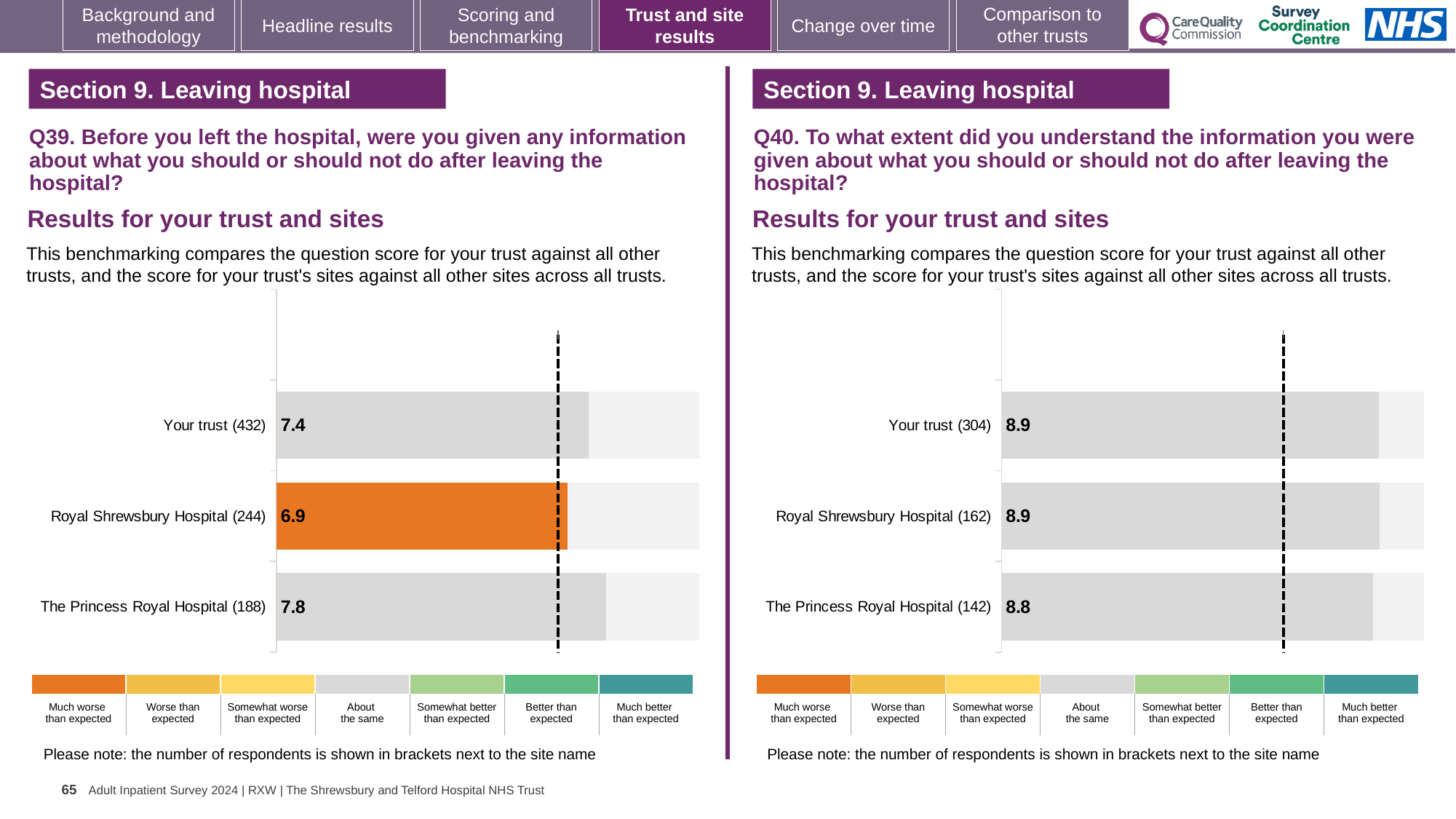
In the Q39 chart on the left, what is the score for Royal Shrewsbury Hospital? 6.9 In the Q39 chart on the left, what is the score for Your trust? 7.4 In the Q39 chart on the left, what is the difference between the scores for The Princess Royal Hospital and Royal Shrewsbury Hospital? 0.9 In the Q39 chart on the left, which bar is coloured orange, indicating 'Much worse than expected'? Royal Shrewsbury Hospital In the Q39 chart on the left, which bar has the lowest score? Royal Shrewsbury Hospital In the Q40 chart on the right, which of Your trust or The Princess Royal Hospital has the higher score? Your trust In the Q40 chart on the right, what is the score for The Princess Royal Hospital? 8.8 In the Q40 chart on the right, how many respondents are shown in brackets for Royal Shrewsbury Hospital? 162 In the Q39 chart on the left, which site has the highest score? The Princess Royal Hospital In the Q40 chart on the right, what is the score for Your trust? 8.9 What type of chart is used on the left for Q39? Bar chart In the Q39 chart on the left, how many bars are plotted? 3